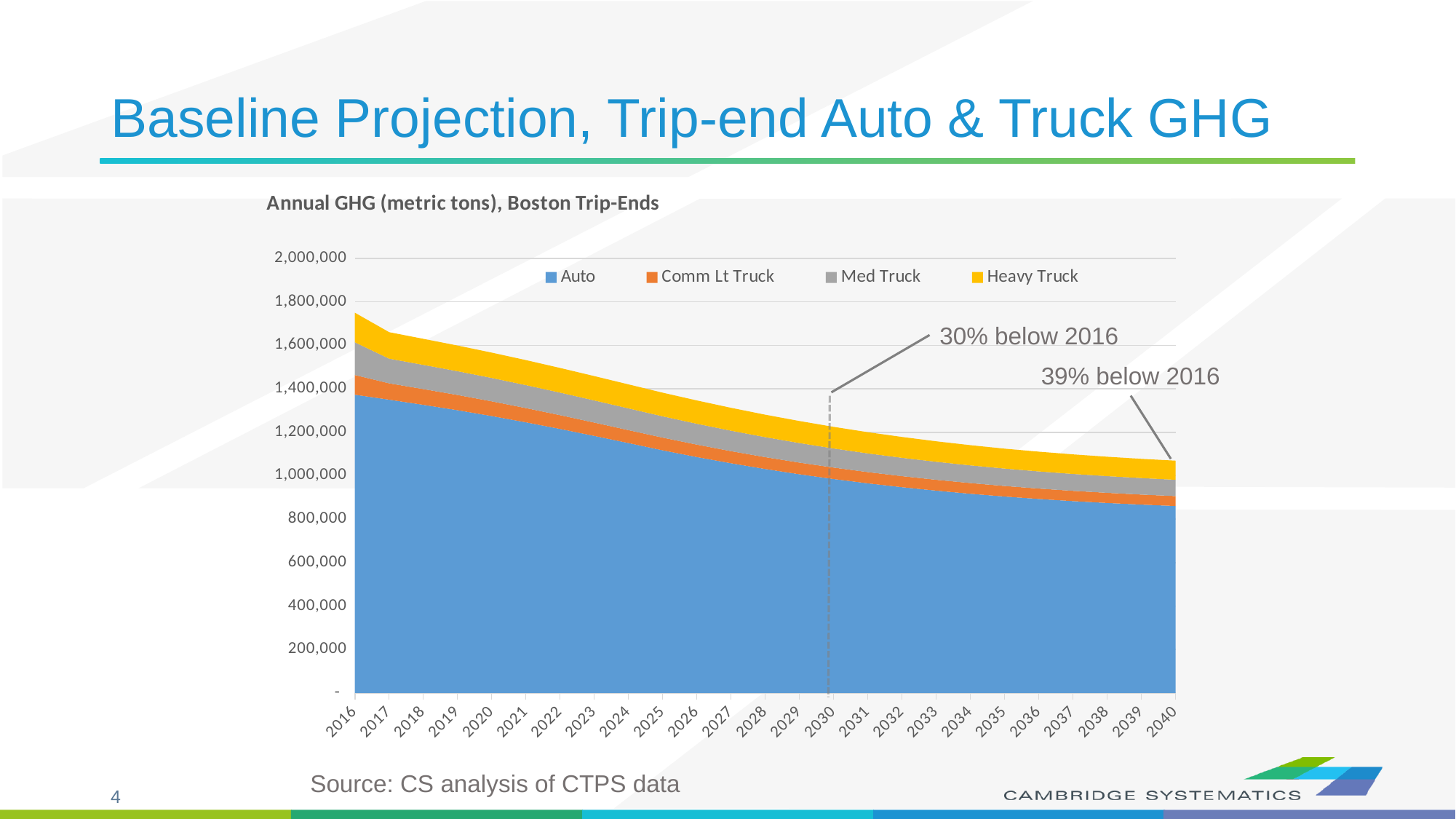
How many years are shown along the x axis? 25 What is the title of the chart? Annual GHG (metric tons), Boston Trip-Ends What kind of chart is shown on the slide? Stacked area chart Which series contributes the largest share of annual GHG emissions? Auto Do total annual GHG emissions rise or fall from 2016 to 2040? Fall How many series does the legend list? 4 In 2016, which is larger: the Auto value or the Heavy Truck value? Auto Is the total annual GHG value for 2040 greater or less than 1,200,000? less Is the Auto value for 2040 greater or less than 1,000,000? less Is the total annual GHG value for 2016 greater or less than 1,600,000? greater According to the annotation, how far below 2016 levels are emissions in 2030? 30% below 2016